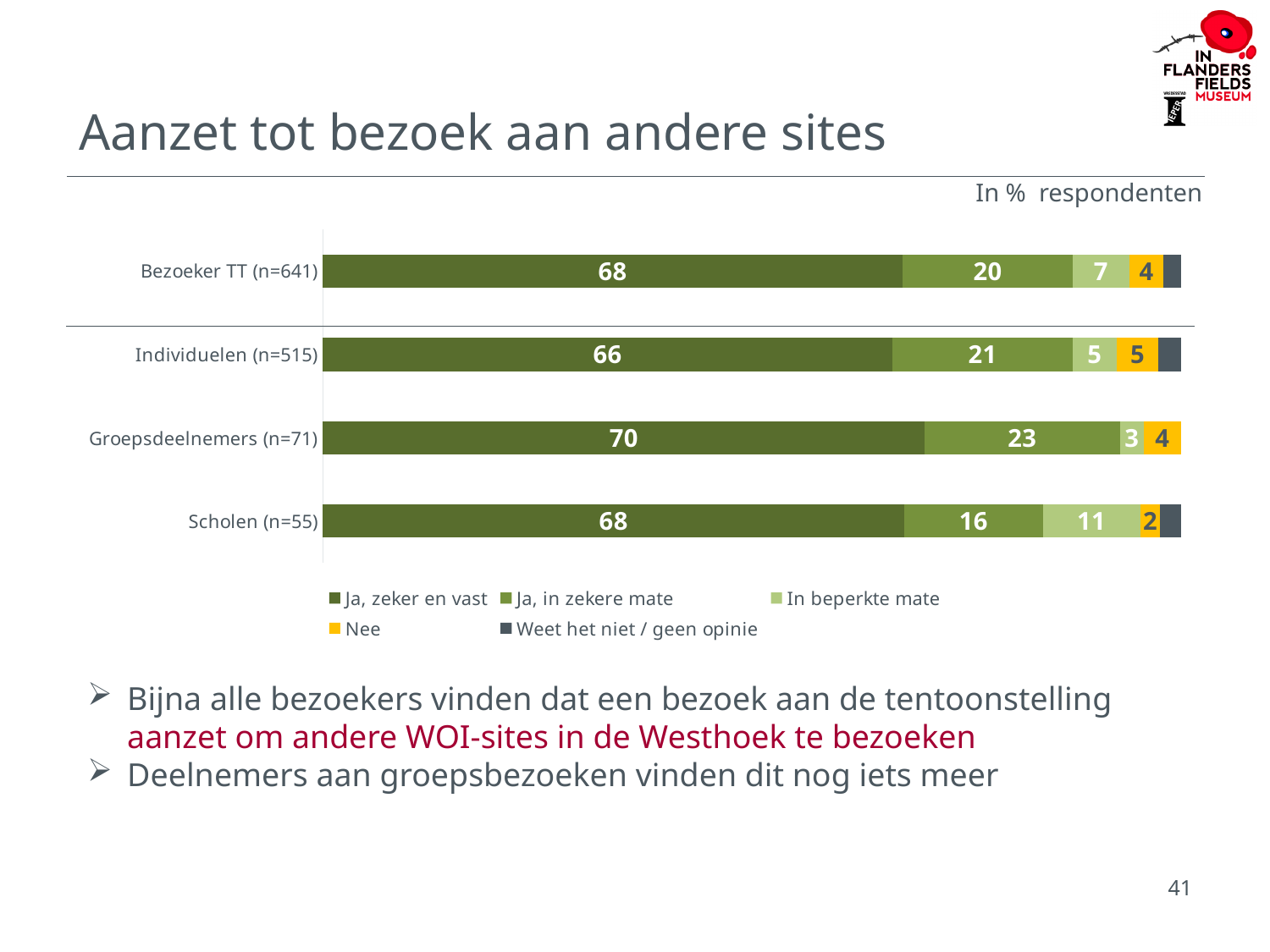
What is the value of "Ja, in zekere mate" for Scholen (n=55)? 16 Which category has the highest value for "Ja, zeker en vast"? Groepsdeelnemers (n=71) Which category has the lowest value for "Ja, in zekere mate"? Scholen (n=55) What is the value of "Ja, zeker en vast" for Groepsdeelnemers (n=71)? 70 What is the difference between the "Ja, zeker en vast" values for Groepsdeelnemers (n=71) and Individuelen (n=515)? 4 How many series does the legend list? 5 How many categories are shown on the chart? 4 What is the value of "In beperkte mate" for Bezoeker TT (n=641)? 7 What kind of chart is shown on the slide? Stacked bar chart Which category has the highest value for "In beperkte mate"? Scholen (n=55) Which has the larger "In beperkte mate" value, Scholen (n=55) or Bezoeker TT (n=641)? Scholen (n=55) What is the value of "Nee" for Individuelen (n=515)? 5